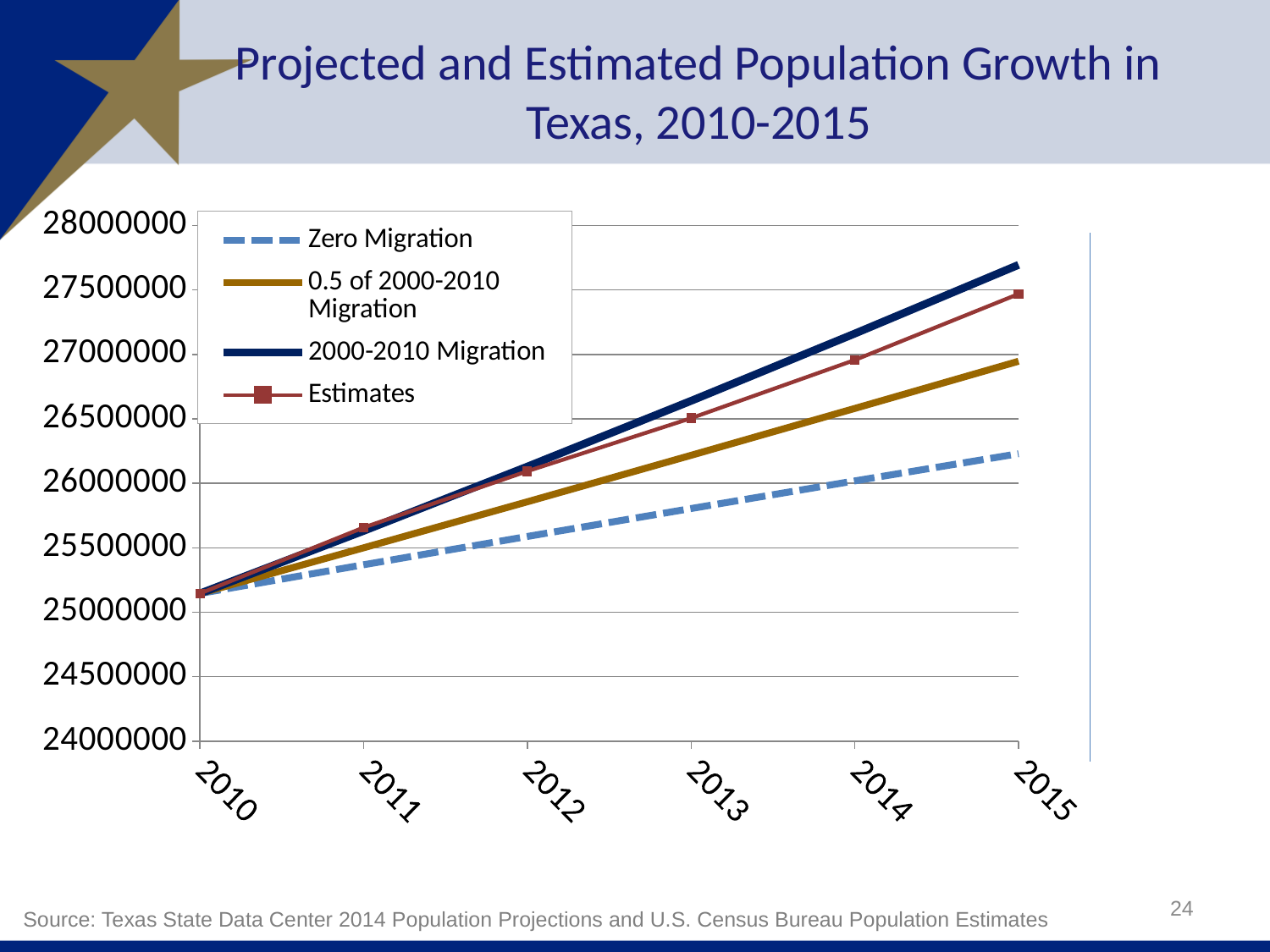
Do the values of the Estimates series rise or fall from 2010 to 2015? rise Which series has the highest value in 2015? 2000-2010 Migration Is the 2000-2010 Migration value for 2015 greater or less than 27500000? greater Is the Zero Migration value for 2015 greater or less than 26000000? greater What kind of chart is shown on the slide? line chart In 2015, which is larger: the Estimates value or the 0.5 of 2000-2010 Migration value? Estimates Is the Estimates value for 2011 greater or less than 25500000? greater How many years are shown along the x axis? 6 Which series is drawn with a dashed line? Zero Migration How many series does the legend list? 4 Which series has the lowest value in 2015? Zero Migration